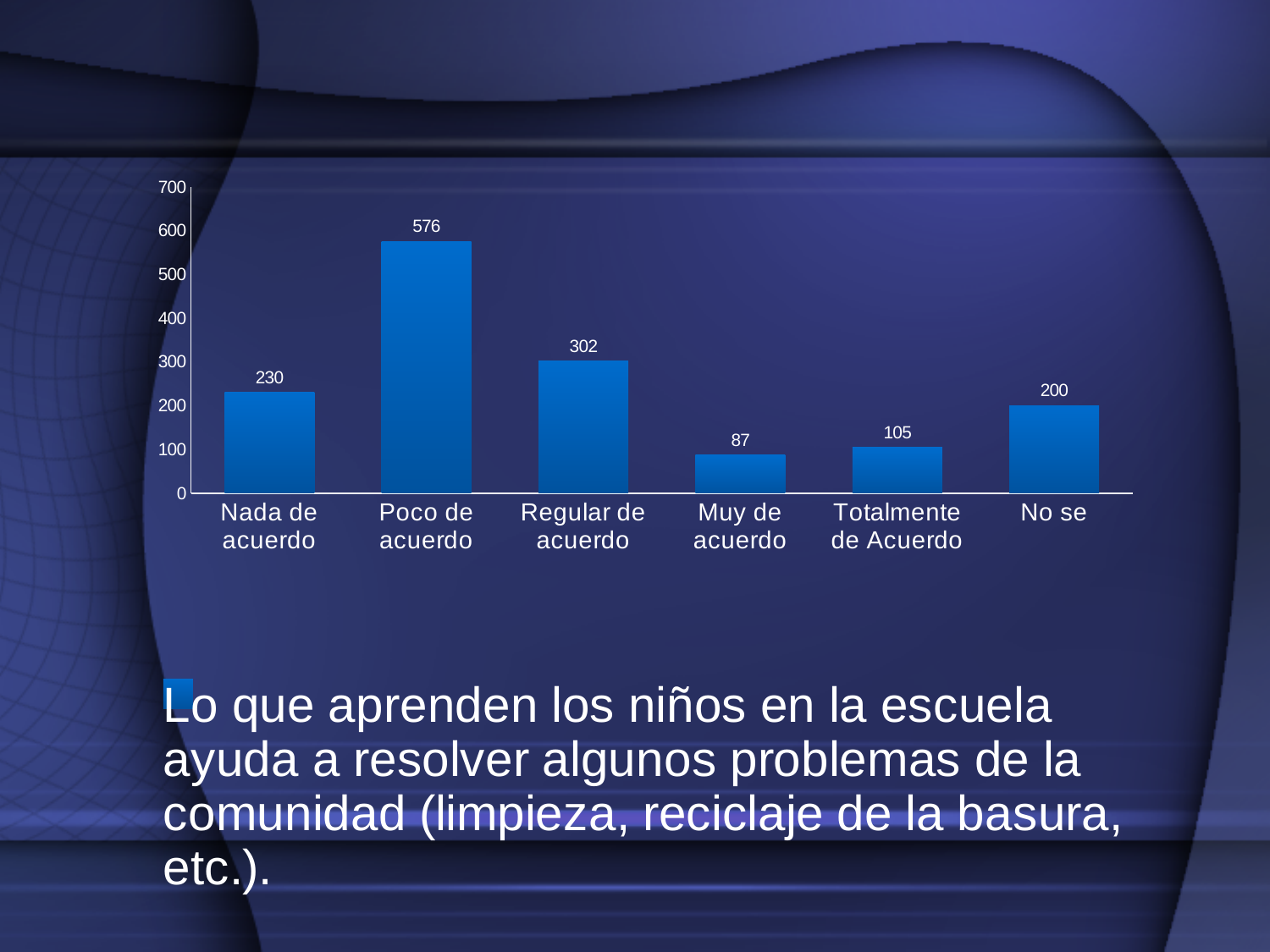
Which is larger, the value for "Nada de acuerdo" or the value for "Regular de acuerdo"? Regular de acuerdo What is the value for "Muy de acuerdo"? 87 What is the value for "Totalmente de Acuerdo"? 105 What kind of chart is shown on the slide? Bar chart What is the difference between the values for "Nada de acuerdo" and "No se"? 30 What is the difference between the values for "Poco de acuerdo" and "Regular de acuerdo"? 274 How many categories are shown on the x axis? 6 What is the value for "Poco de acuerdo"? 576 What is the highest value shown on the y axis? 700 What is the value for "No se"? 200 Which category has the highest value? Poco de acuerdo Which category has the lowest value? Muy de acuerdo